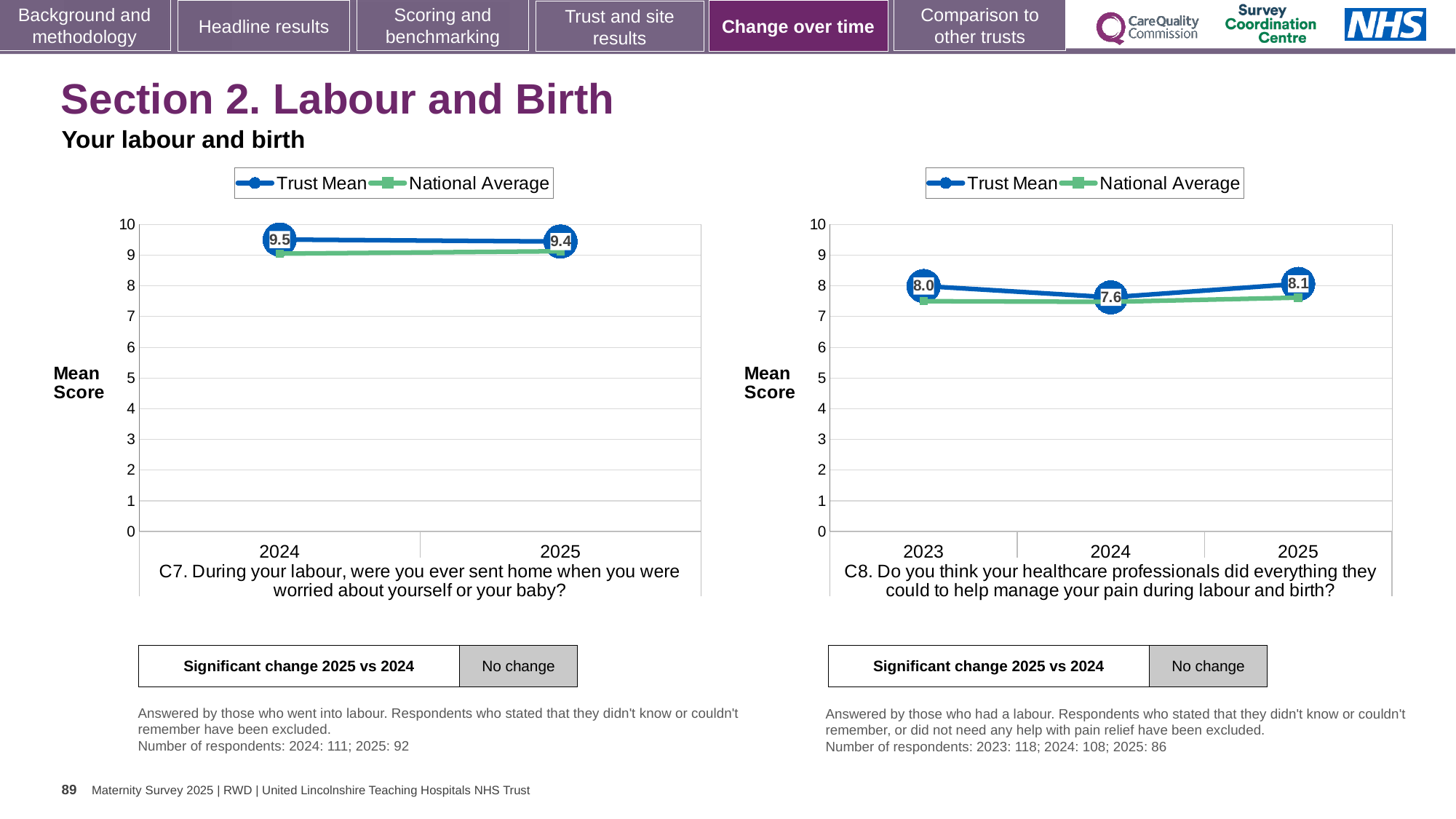
In the C7 chart, what is the Trust Mean for 2025? 9.4 In the C8 chart, what is the difference between the Trust Mean for 2025 and 2024? 0.5 In the C7 chart, what is the difference between the Trust Mean for 2024 and 2025? 0.1 In the C7 chart, is the National Average for 2024 greater or less than 8? greater How many series does the legend of the C7 chart list? 2 In the C8 chart, which year has the highest Trust Mean? 2025 In the C8 chart, what is the Trust Mean for 2024? 7.6 In the C8 chart, is the Trust Mean for 2023 or 2025 higher? 2025 In the C8 chart, what is the Trust Mean for 2025? 8.1 In the C7 chart, what is the Trust Mean for 2024? 9.5 In the C8 chart, which year has the lowest Trust Mean? 2024 How many years are plotted in the C8 chart? 3